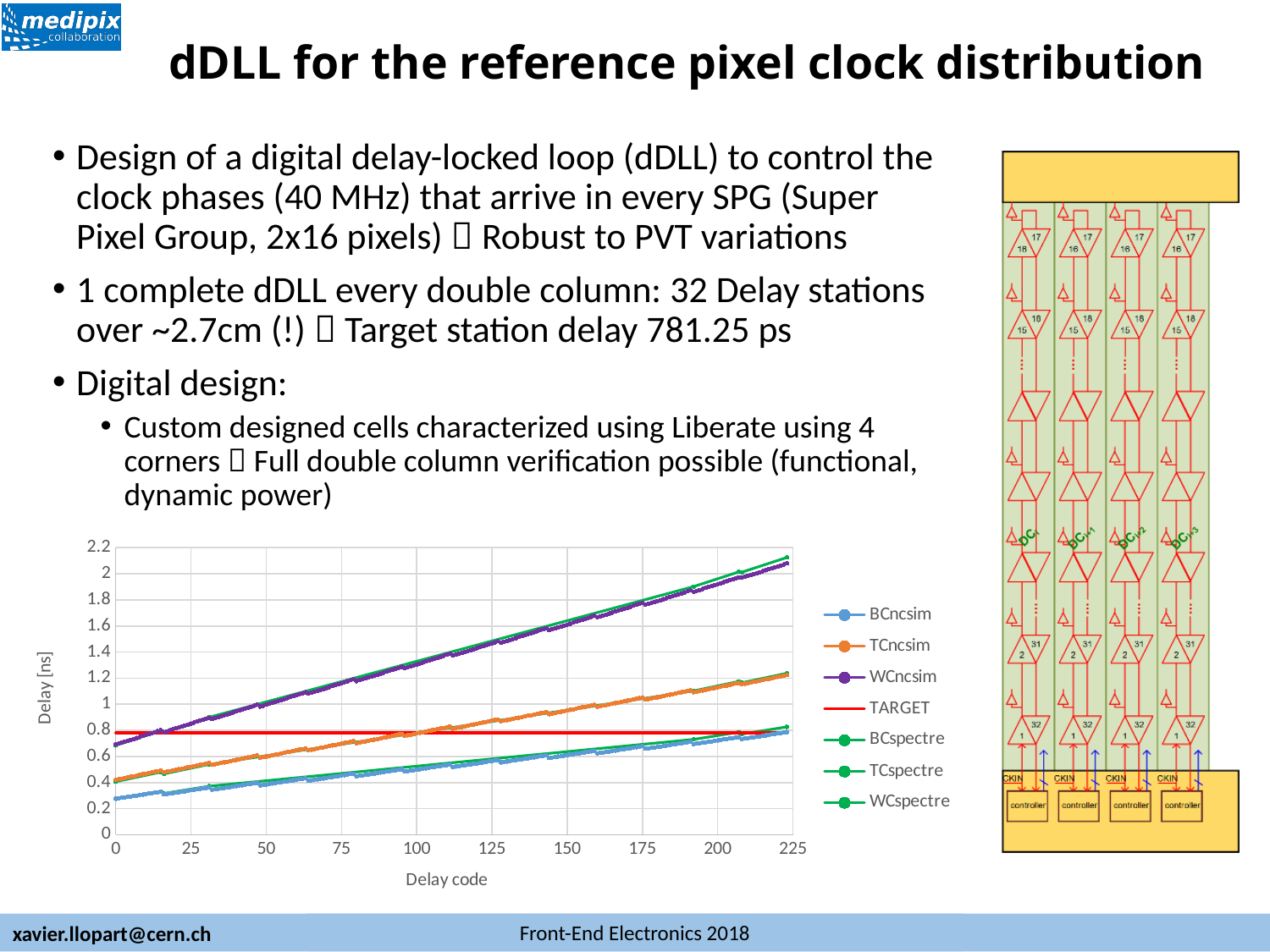
What kind of chart is shown on the slide? line chart How many series does the chart legend list? 7 Is the WCncsim delay at delay code 200 greater or less than 1.8? greater Is the BCncsim delay at delay code 0 greater or less than 0.4? less At delay code 100, which series has the larger delay, WCncsim or TCncsim? WCncsim Is the WCncsim delay at delay code 0 greater or less than 0.8? less Which series reaches the highest delay at the largest delay codes? WCspectre What is the title of the x axis of the chart? Delay code Do the BCncsim, TCncsim and WCncsim delay values rise or fall as the delay code increases? rise What is the title of the y axis of the chart? Delay [ns]